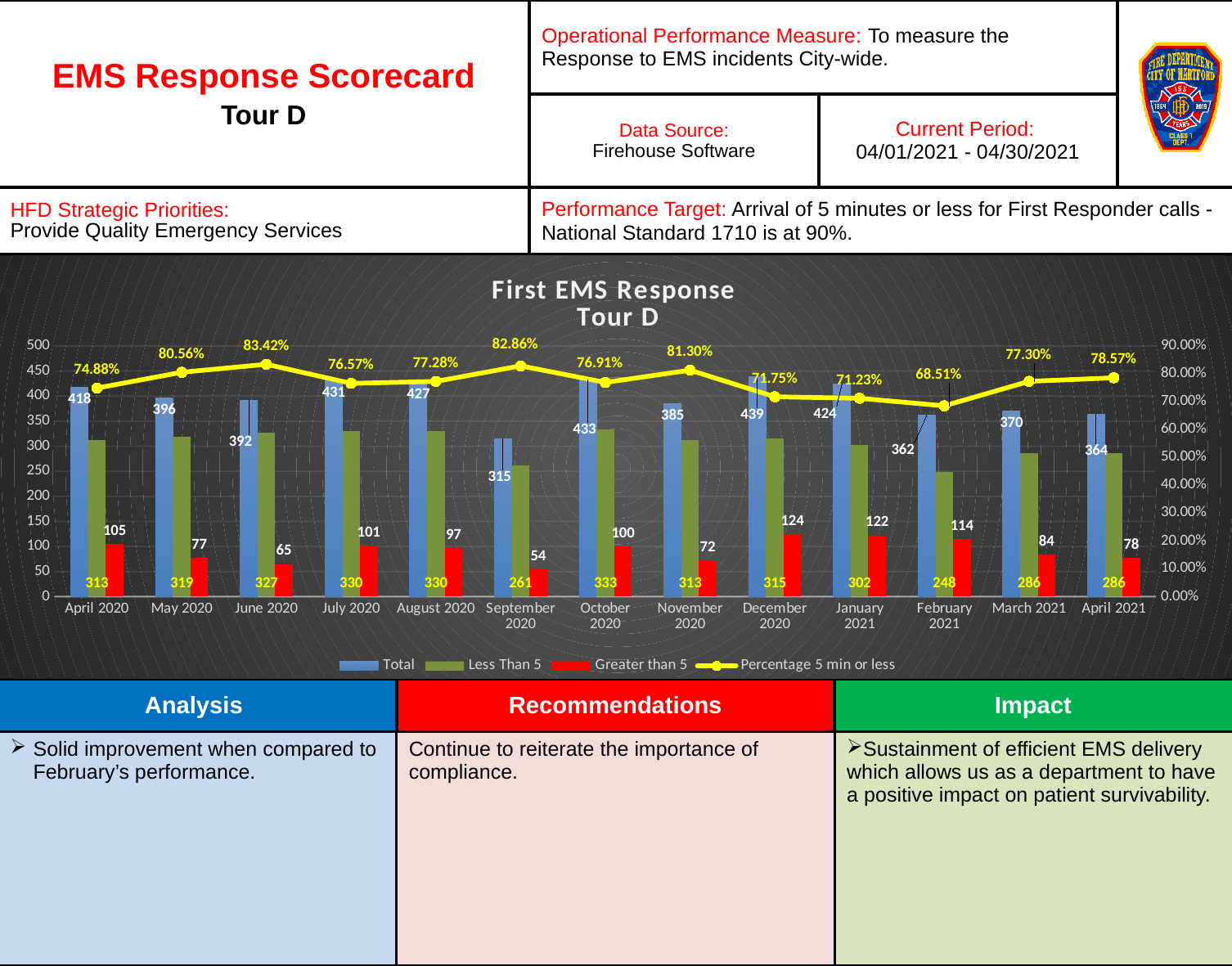
How many series does the legend list? 4 What is the Less Than 5 value for September 2020? 261 What is the Total value for December 2020? 439 Is the Total value for July 2020 greater or less than 400? greater What is the Percentage 5 min or less for February 2021? 68.51% Which month has the highest Percentage 5 min or less? June 2020 Which month has the lowest Total value? September 2020 Which month has the highest Greater than 5 value? December 2020 What kind of chart is shown? Bar chart with a line How many months are shown on the x axis? 13 What is the difference between the Less Than 5 and Greater than 5 values for April 2021? 208 Which is larger, the Greater than 5 value for December 2020 or for January 2021? December 2020